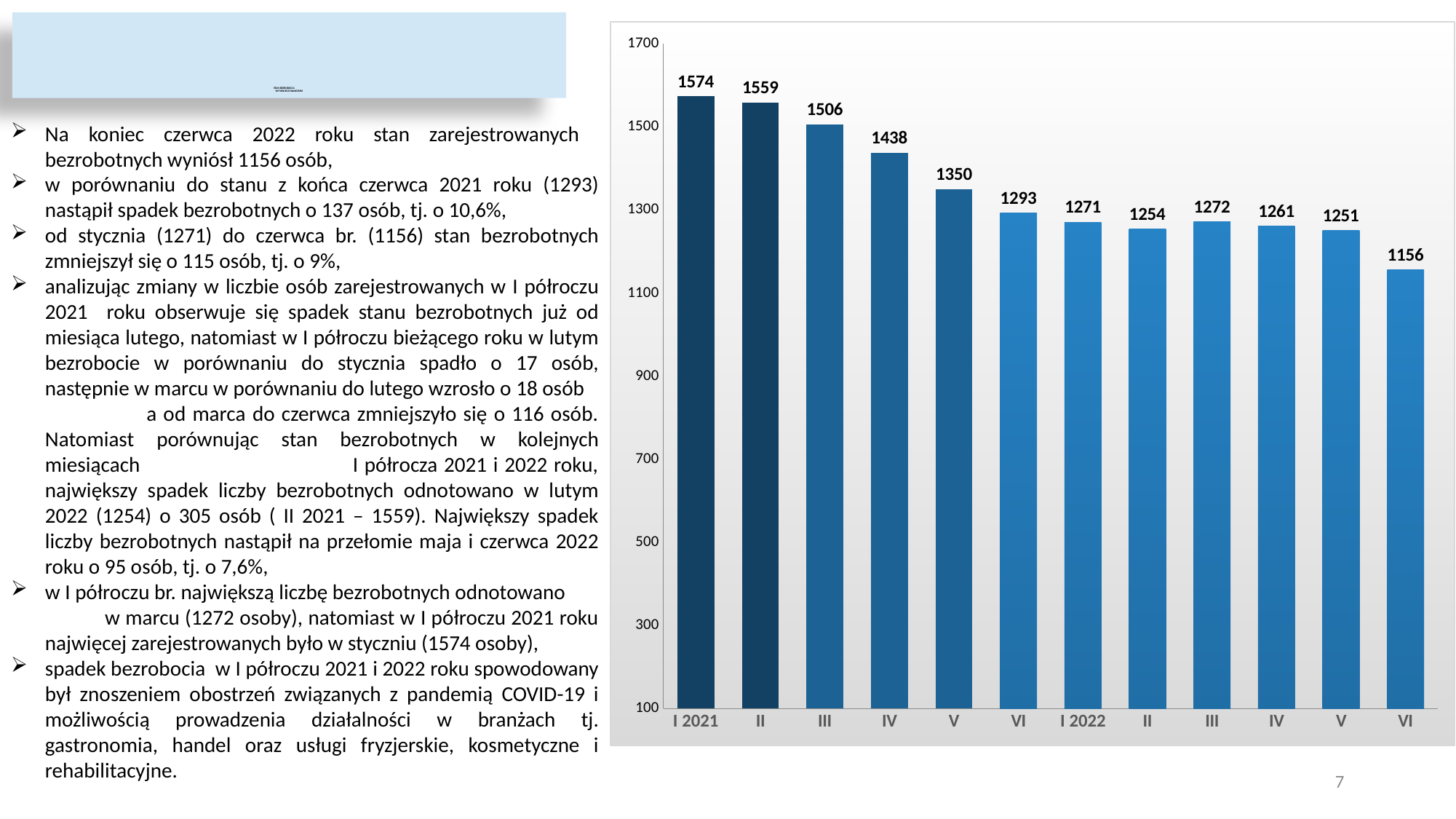
What is the value for I 2022? 1271 Which month has the highest value? I 2021 Which is larger, the value for III 2022 or the value for IV 2022? III 2022 What is the value for V 2021? 1350 What kind of chart is shown on the slide? bar chart Is the value for IV 2021 greater or less than 1500? less What is the difference between the values for II 2021 and II 2022? 305 What is the difference between the values for I 2021 and VI 2022? 418 How many bars are shown in the chart? 12 What is the value for VI 2022 (the last bar)? 1156 Which month has the lowest value? VI 2022 What is the value for I 2021? 1574